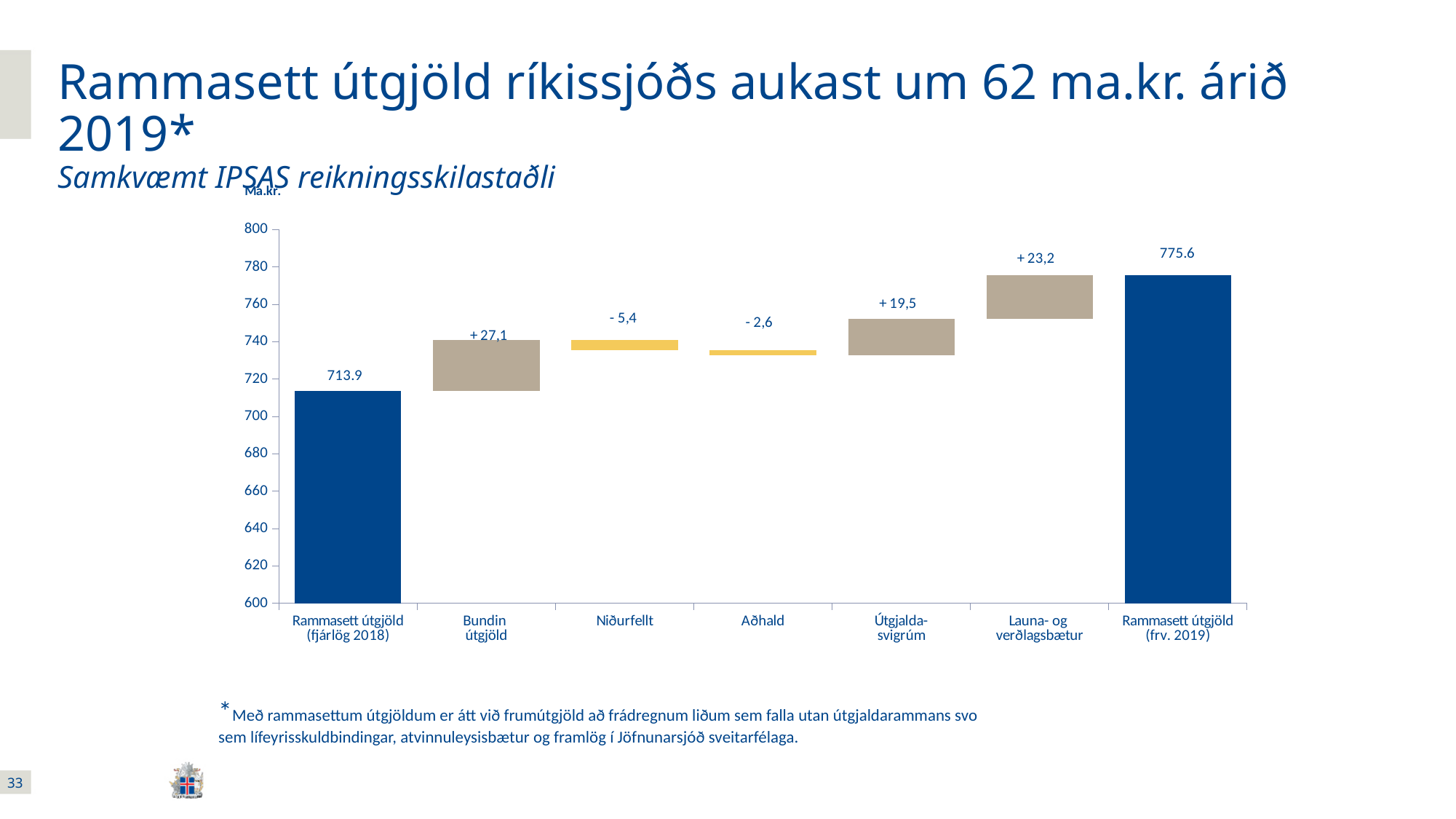
Is the value for Rammasett útgjöld (frv. 2019) greater or less than 760? greater What change is shown for Bundin útgjöld? + 27,1 Which is larger in magnitude, the change for Útgjaldasvigrúm or the change for Aðhald? Útgjaldasvigrúm What is the value shown for Rammasett útgjöld (fjárlög 2018)? 713.9 What unit is shown above the y axis of the chart? Ma.kr. What is the difference between the Rammasett útgjöld (frv. 2019) value and the Rammasett útgjöld (fjárlög 2018) value? 61.7 What change is shown for Launa- og verðlagsbætur? + 23,2 Which category shows the largest positive change? Bundin útgjöld How many categories are shown on the x axis? 7 What change is shown for Niðurfellt? - 5,4 What is the value shown for Rammasett útgjöld (frv. 2019)? 775.6 Which category shows the largest negative change? Niðurfellt